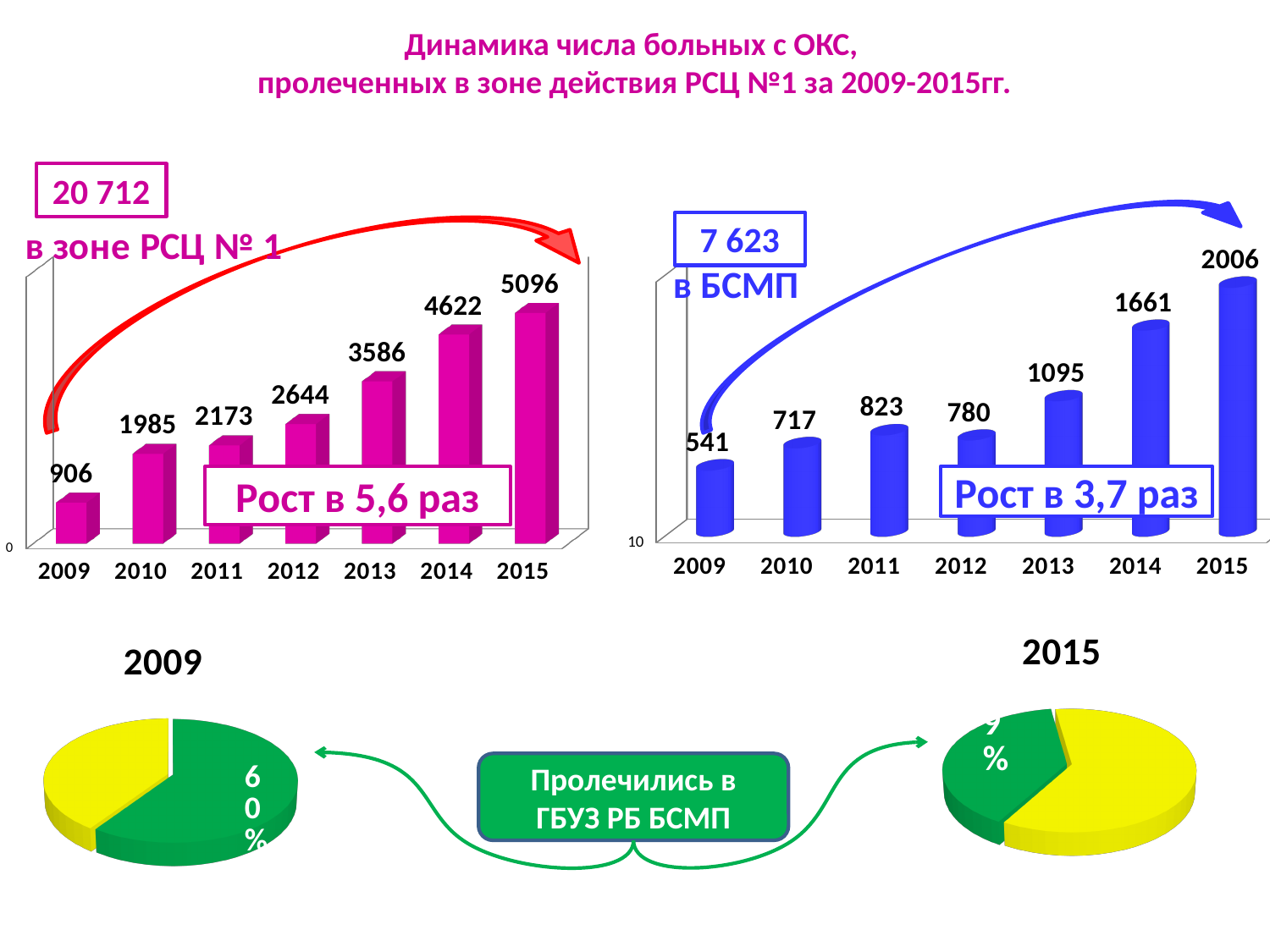
In the right bar chart (в БСМП), which year has the lowest value? 2009 What total is shown in the box above the left bar chart (в зоне РСЦ № 1)? 20 712 In the 2009 pie chart, what share is shown for the green slice? 60% In the right bar chart (в БСМП), what is the difference between the values for 2013 and 2012? 315 In the left bar chart (в зоне РСЦ № 1), do the values rise or fall from 2009 to 2015? rise What kind of chart is the chart labelled 'в БСМП'? bar chart In the left bar chart (в зоне РСЦ № 1), what is the value for 2013? 3586 In the right bar chart (в БСМП), which is larger: the value for 2011 or the value for 2012? 2011 In the left bar chart (в зоне РСЦ № 1), which year has the highest value? 2015 In the left bar chart (в зоне РСЦ № 1), what is the difference between the values for 2015 and 2009? 4190 How many years are shown on the x axis of the left bar chart (в зоне РСЦ № 1)? 7 In the right bar chart (в БСМП), what is the value for 2014? 1661